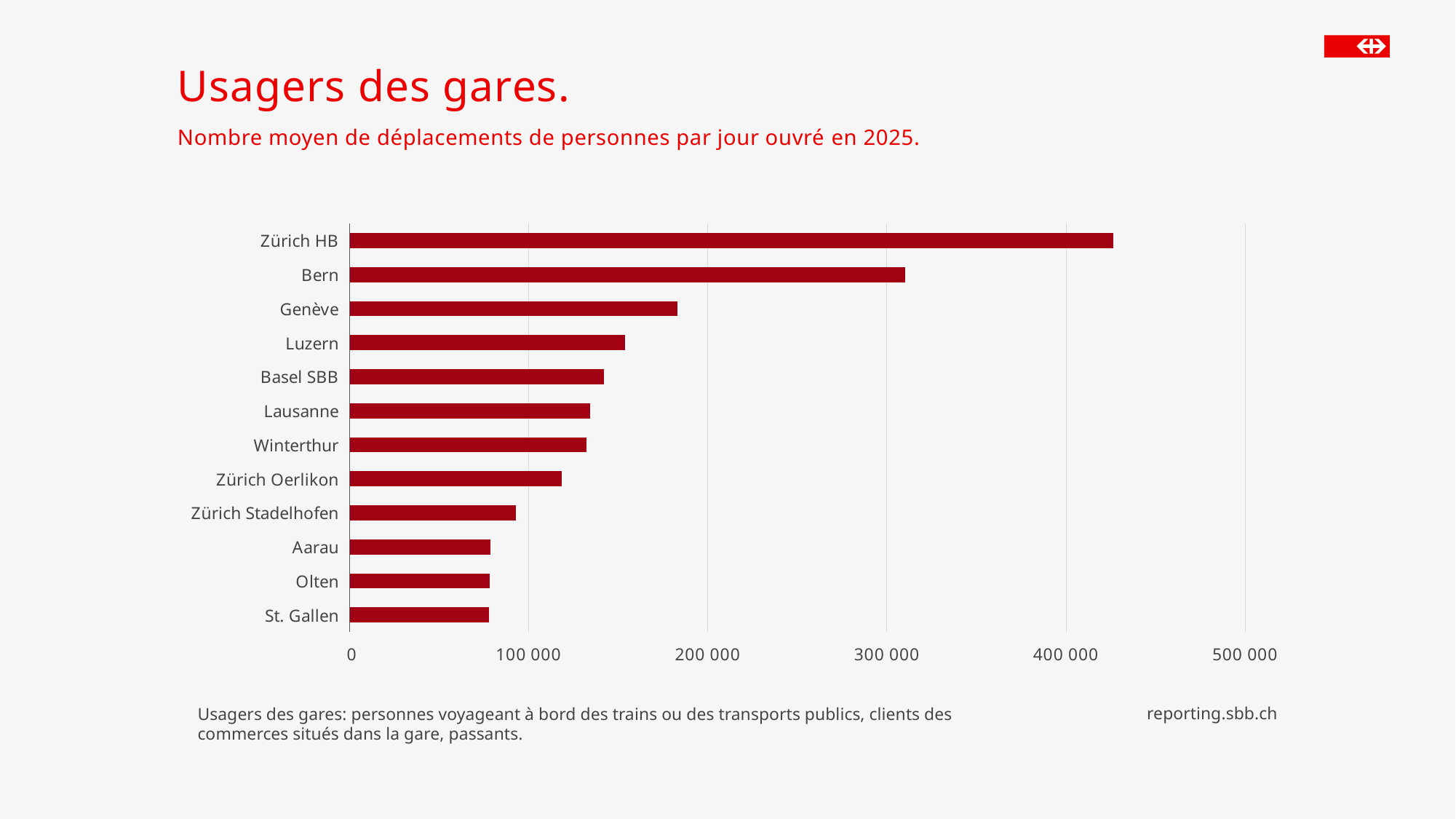
Do the bar values increase or decrease from the top of the chart to the bottom? decrease Is the value for Zürich HB greater or less than 400 000? greater What kind of chart is shown on the slide? bar chart Is the value for Zürich Stadelhofen greater or less than 100 000? less Which has more users, Luzern or Basel SBB? Luzern How many stations are shown in the chart? 12 What is the title of the slide? Usagers des gares. Which station has the highest number of users? Zürich HB Is the value for Aarau greater or less than 100 000? less Which has more users, Bern or Genève? Bern